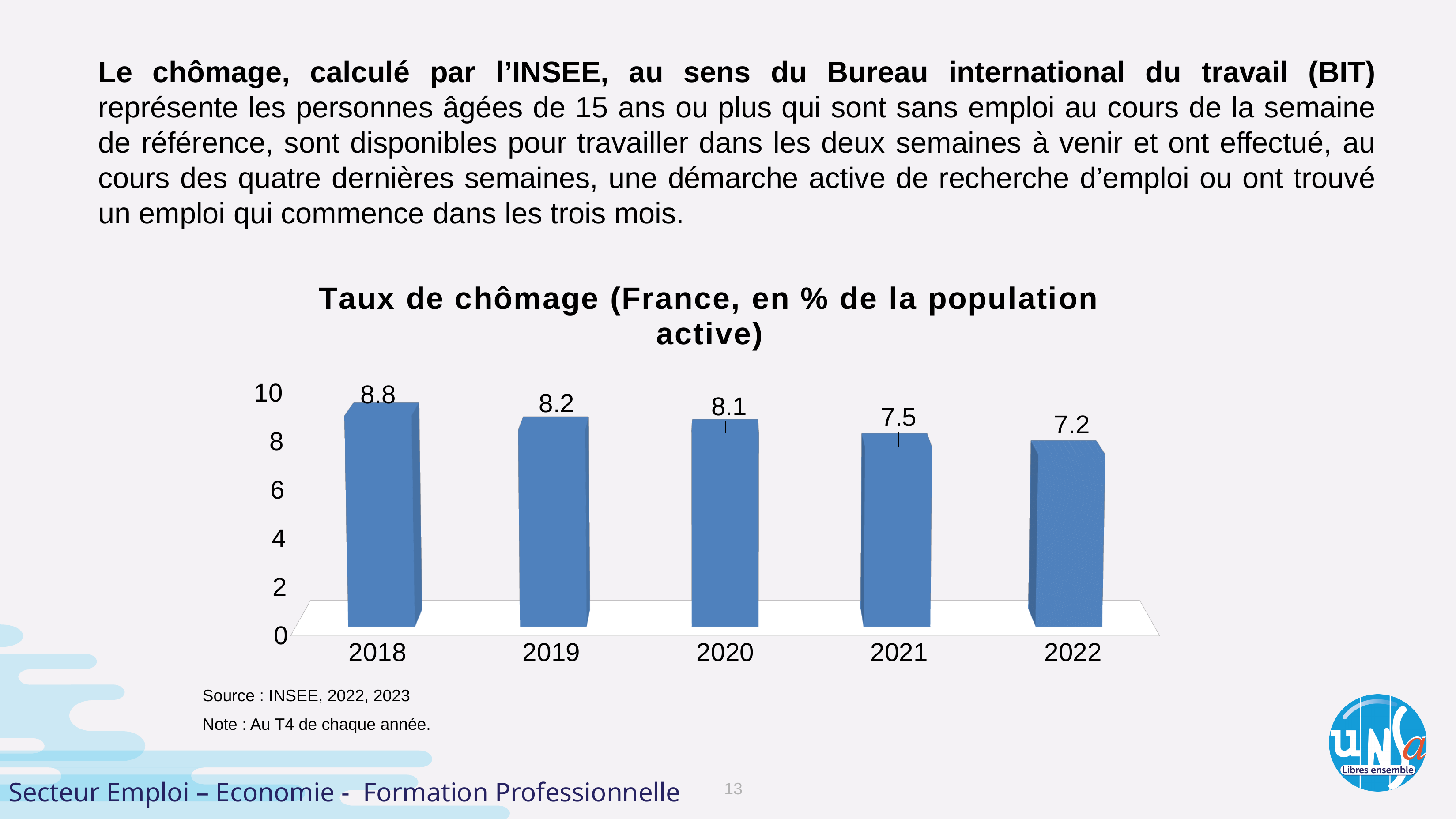
What is the unemployment rate shown for 2018? 8.8 Is the value for 2021 greater or less than 8? less Which year has the highest unemployment rate? 2018 What is the difference between the 2019 and 2021 values? 0.7 What is the value for 2020? 8.1 What is the difference between the 2018 and 2022 values? 1.6 What kind of chart is shown on the slide? bar chart Do the values rise or fall from 2018 to 2022? fall Which year has the lowest unemployment rate? 2022 What is the unemployment rate shown for 2022? 7.2 Which is larger, the value for 2019 or the value for 2021? 2019 How many years are shown on the x axis? 5